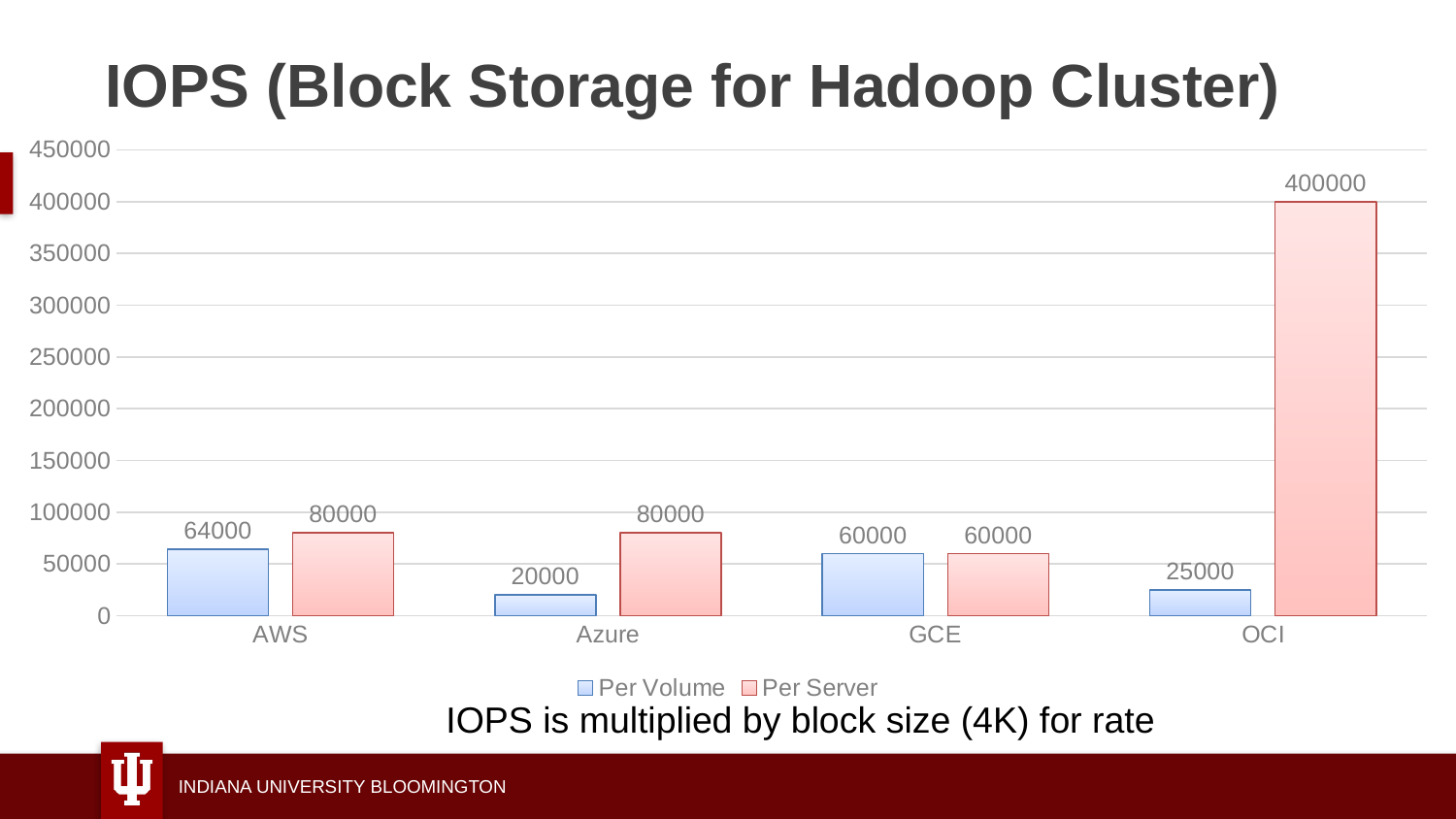
What is the Per Volume IOPS value for Azure? 20000 Is the Per Server value for OCI greater or less than 350000? greater How many series does the legend list? 2 Which provider has the highest Per Server IOPS value? OCI What kind of chart is shown on the slide? Bar chart What is the Per Volume IOPS value for AWS? 64000 Which is larger for AWS, the Per Volume value or the Per Server value? Per Server What is the difference between the Per Server and Per Volume values for OCI? 375000 Which provider has the lowest Per Volume IOPS value? Azure How many providers are shown on the x axis? 4 What is the title of the chart? IOPS (Block Storage for Hadoop Cluster) What is the Per Server IOPS value for OCI? 400000